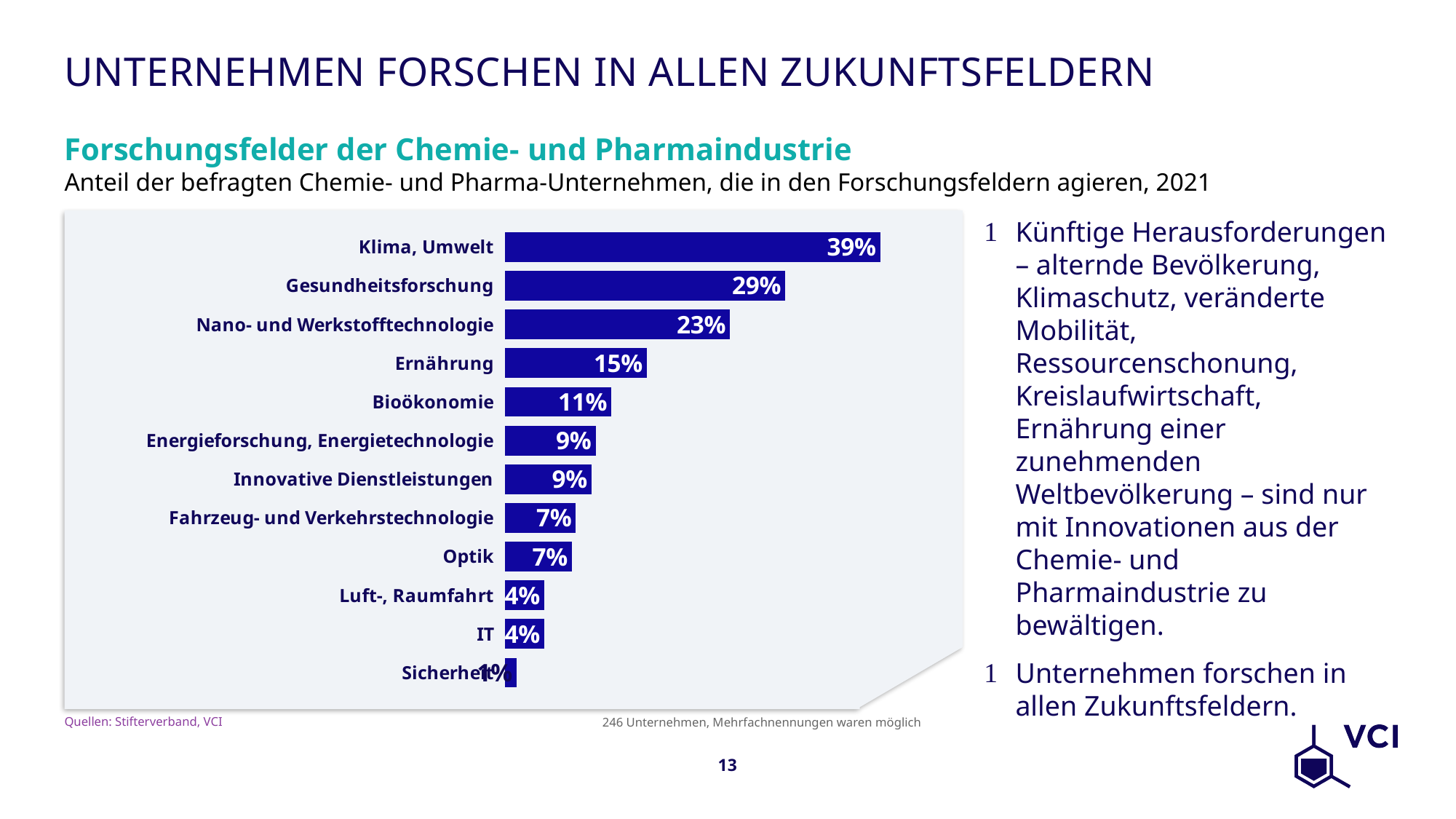
Which research field has the highest share? Klima, Umwelt Which is larger, the value for Ernährung or the value for Bioökonomie? Ernährung What share of companies is shown for Klima, Umwelt? 39% What type of chart is shown on the slide? Bar chart What is the difference between the values for Klima, Umwelt and Gesundheitsforschung? 10 percentage points What value is shown for Gesundheitsforschung? 29% What share is shown for Nano- und Werkstofftechnologie? 23% What value is shown for Luft-, Raumfahrt? 4% Which research field has the lowest share? Sicherheit What value is shown for Bioökonomie? 11% How many research fields are shown in the chart? 12 What is the difference between the values for Ernährung and Optik? 8 percentage points